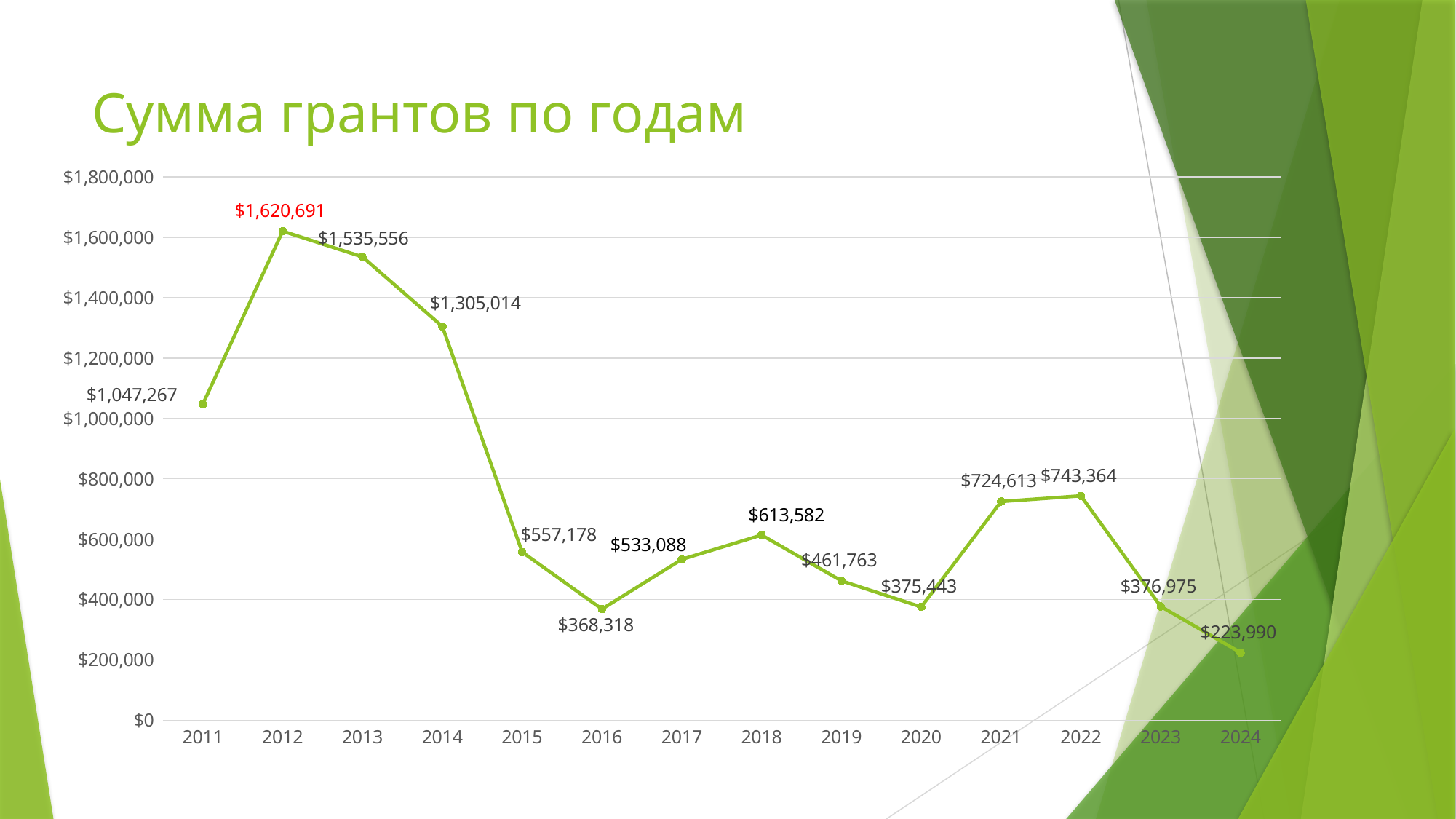
What is the grant amount for 2012? $1,620,691 What is the grant amount for 2016? $368,318 Which year has the highest grant amount? 2012 What is the grant amount for 2024? $223,990 What is the difference between the grant amounts for 2022 and 2021? $18,751 Does the grant amount rise or fall from 2012 to 2016? fall What is the difference between the grant amounts for 2012 and 2011? $573,424 What is the title of the chart? Сумма грантов по годам How many years are plotted on the chart? 14 Which year has a larger grant amount, 2018 or 2019? 2018 What type of chart is shown on the slide? line chart Which year has the lowest grant amount? 2024